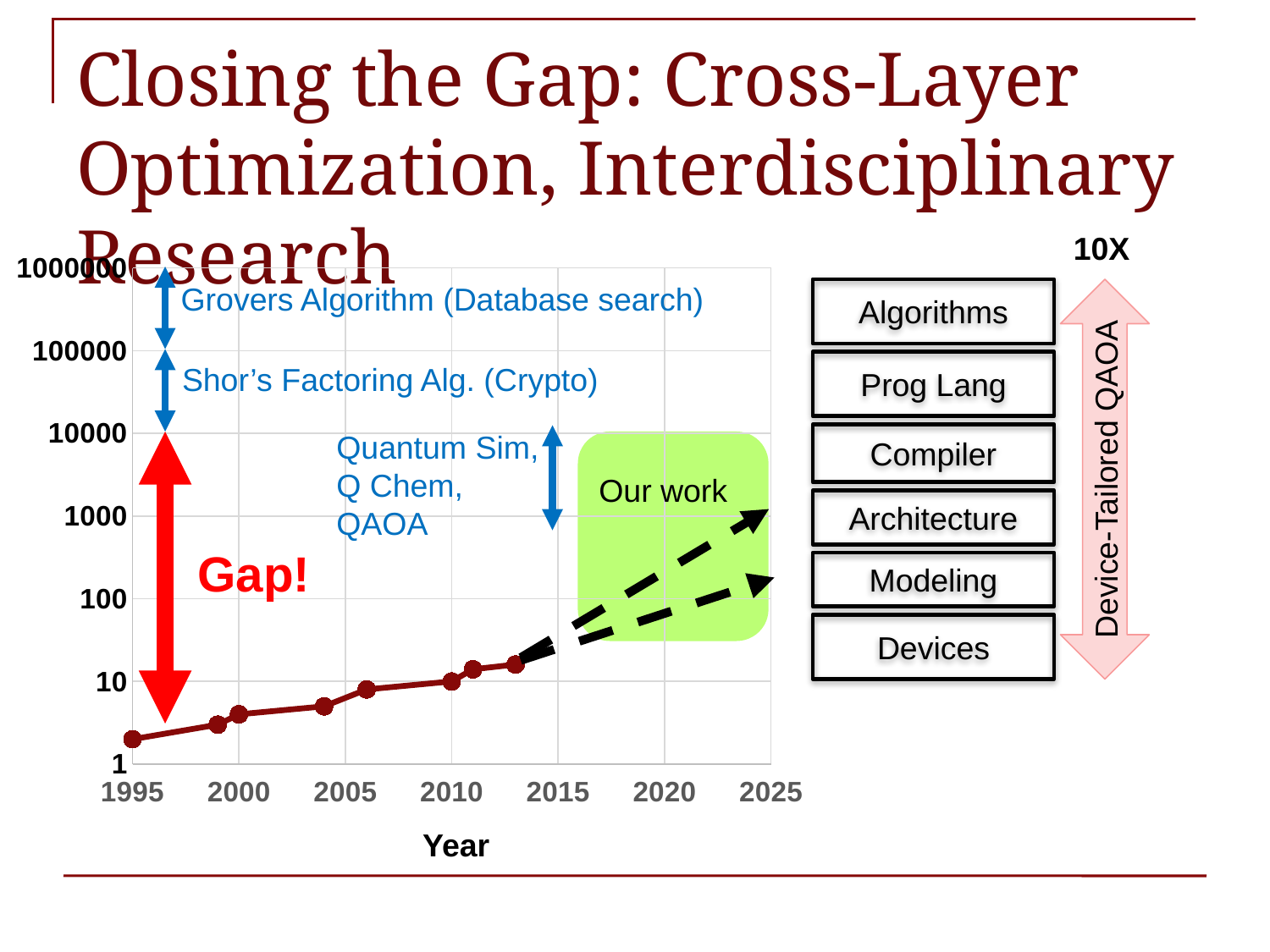
What is the lowest tick value shown on the y axis? 1 Is the plotted value for 1995 greater or less than 10? less How many year tick labels are shown on the x axis? 7 What kind of chart is shown on the slide? line chart Is the plotted value for the last data point (around 2013) greater or less than 100? less What is the highest tick value shown on the y axis? 1000000 Do the plotted values rise or fall as the year increases along the x axis? rise What is the last year label on the x axis? 2025 Is the plotted value for the last data point (around 2013) greater or less than 10? greater What is the label of the x axis of the chart? Year Which plotted value is larger, the one at 1995 or the one at the last data point around 2013? the one around 2013 What is the first year label on the x axis? 1995